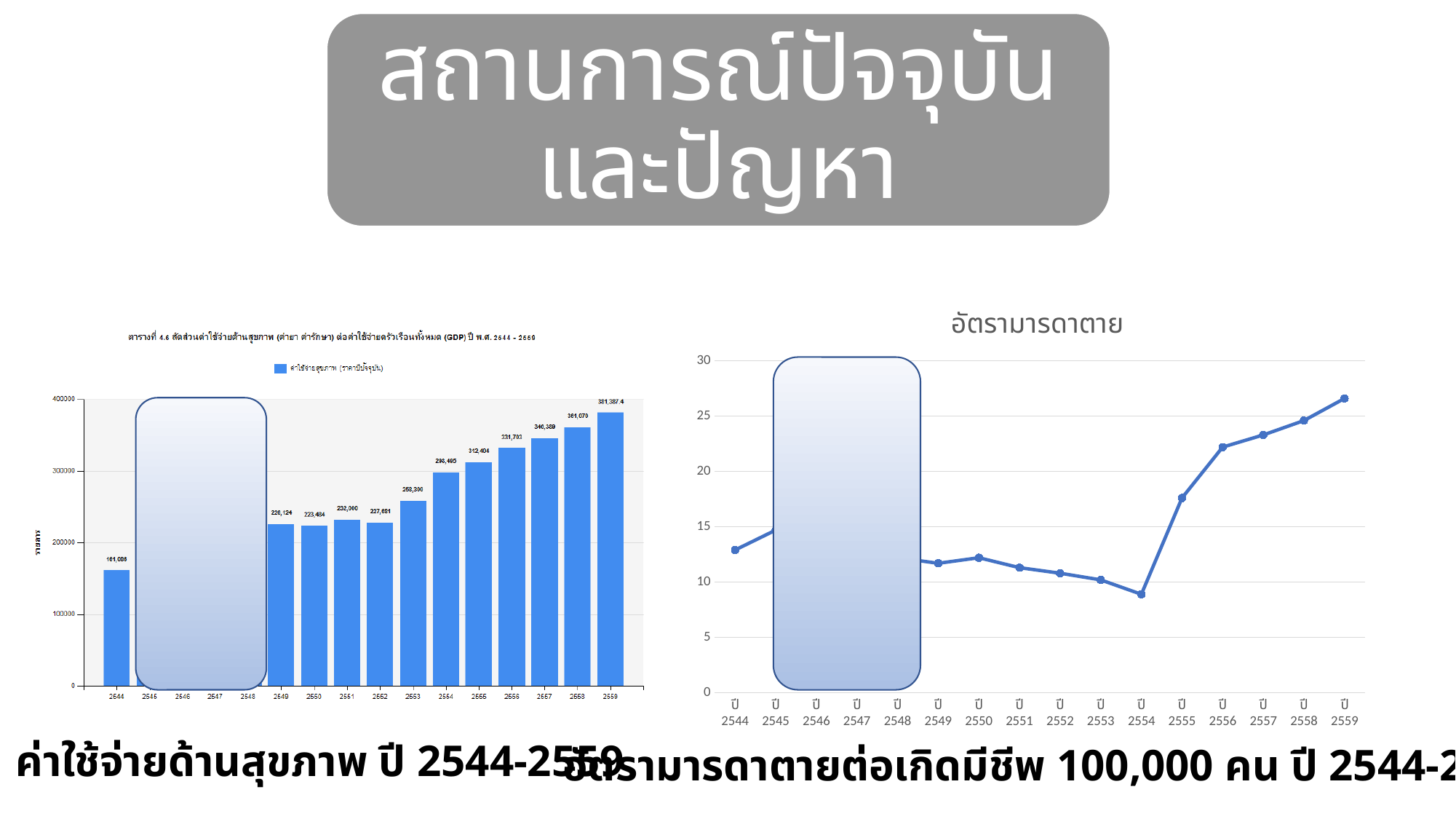
In the bar chart on the left, what is the difference between the values for 2559 and 2558? 20,317.4 What kind of chart is the chart on the left of the slide? bar chart In the bar chart on the left, which year has the highest value? 2559 How many years are shown on the x axis of the line chart on the right? 16 In the line chart on the right, is the value for ปี 2559 greater or less than 25? greater What kind of chart is the chart titled อัตรามารดาตาย on the right? line chart In the line chart on the right, which year has the lowest value? ปี 2554 In the line chart on the right, is the value for ปี 2554 greater or less than 10? less In the bar chart on the left, what is the value for 2553? 258,300 In the bar chart on the left, which is larger, the value for 2550 or the value for 2551? 2551 In the bar chart on the left, what is the value for 2559? 381,387.4 In the line chart on the right, do the values rise or fall from ปี 2555 to ปี 2559? rise